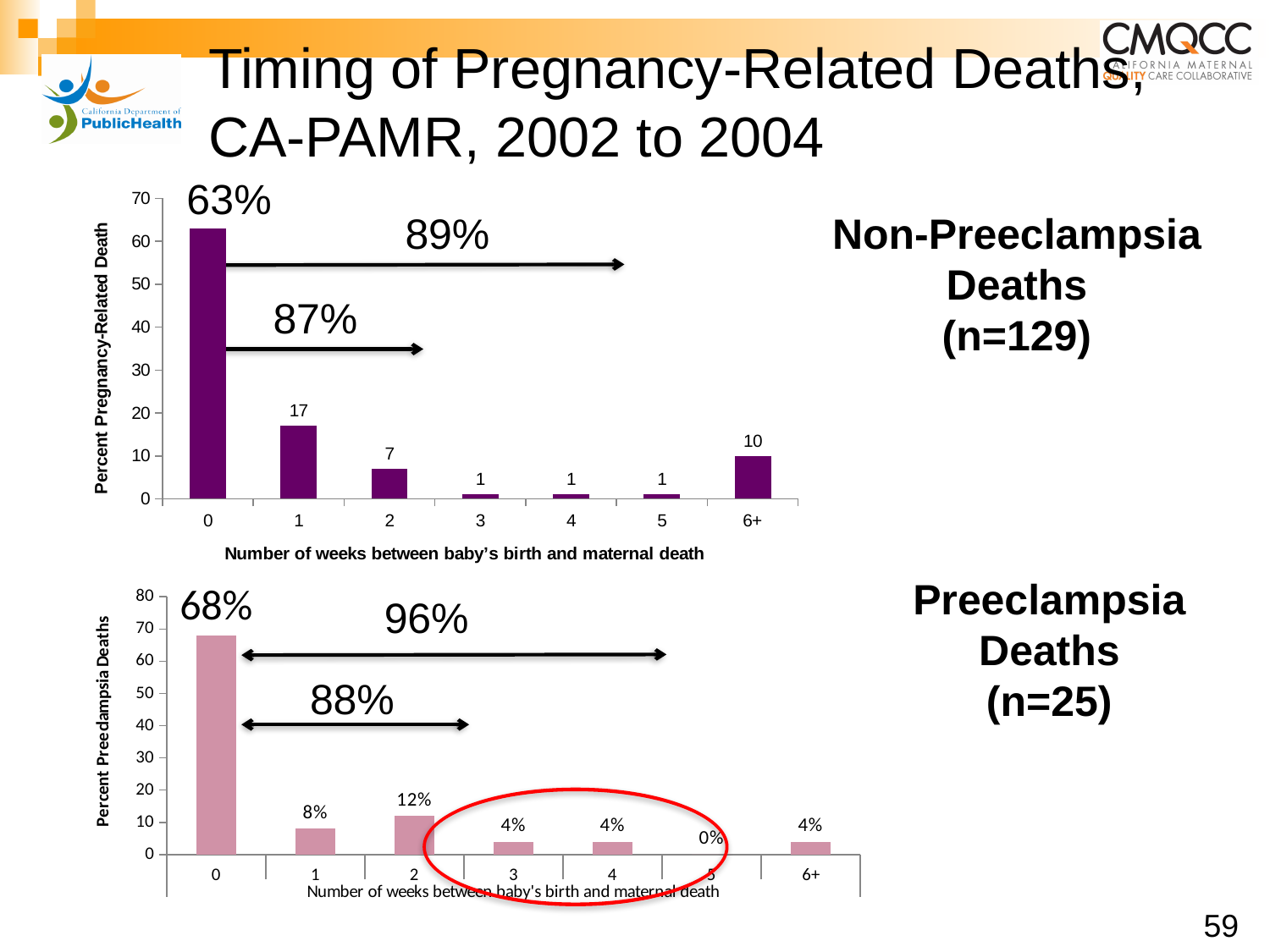
In the Non-Preeclampsia Deaths chart, which number of weeks has the highest value? 0 In the Preeclampsia Deaths chart, is the value for 0 weeks greater or less than 60? greater In the Preeclampsia Deaths chart, what is the value for 5 weeks? 0% In the Preeclampsia Deaths chart, which number of weeks has the lowest value? 5 In the Preeclampsia Deaths chart, what is the value for 2 weeks between baby's birth and maternal death? 12% How many categories are shown on the x axis of the Preeclampsia Deaths chart? 7 What kind of chart is the Non-Preeclampsia Deaths chart? Bar chart In the Non-Preeclampsia Deaths chart, what is the difference between the values for 1 week and 2 weeks? 10 In the Non-Preeclampsia Deaths chart, which is larger: the value for 2 weeks or the value for 6+ weeks? 6+ weeks In the Non-Preeclampsia Deaths chart, what is the value for 1 week between baby's birth and maternal death? 17 In the Preeclampsia Deaths chart, what is the difference between the values for 0 weeks and 1 week? 60% In the Non-Preeclampsia Deaths chart, what is the value for 6+ weeks? 10